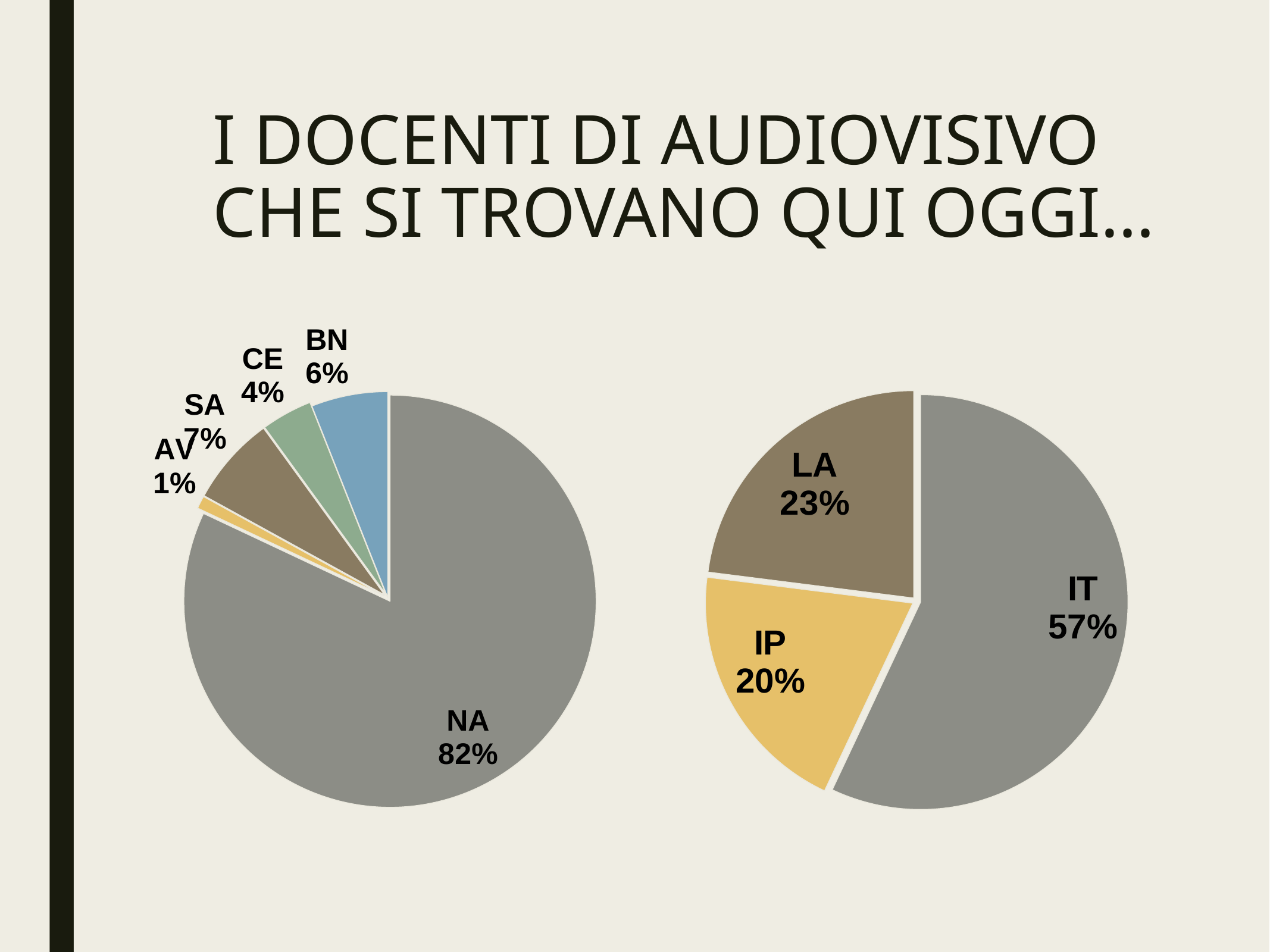
In the left pie chart, which category has the largest share? NA In the left pie chart, what is the share for BN? 6% In the left pie chart, what is the difference between the shares of SA and CE? 3% In the left pie chart, how many slices are there? 5 What kind of chart is shown on the right of the slide? Pie chart In the right pie chart, which category has the largest share? IT In the right pie chart, what is the difference between the shares of IT and LA? 34% In the right pie chart, what is the share for IP? 20% In the left pie chart, what is the share for NA? 82% In the right pie chart, which is larger, LA or IP? LA In the left pie chart, what is the share for SA? 7% In the left pie chart, which category has the smallest share? AV